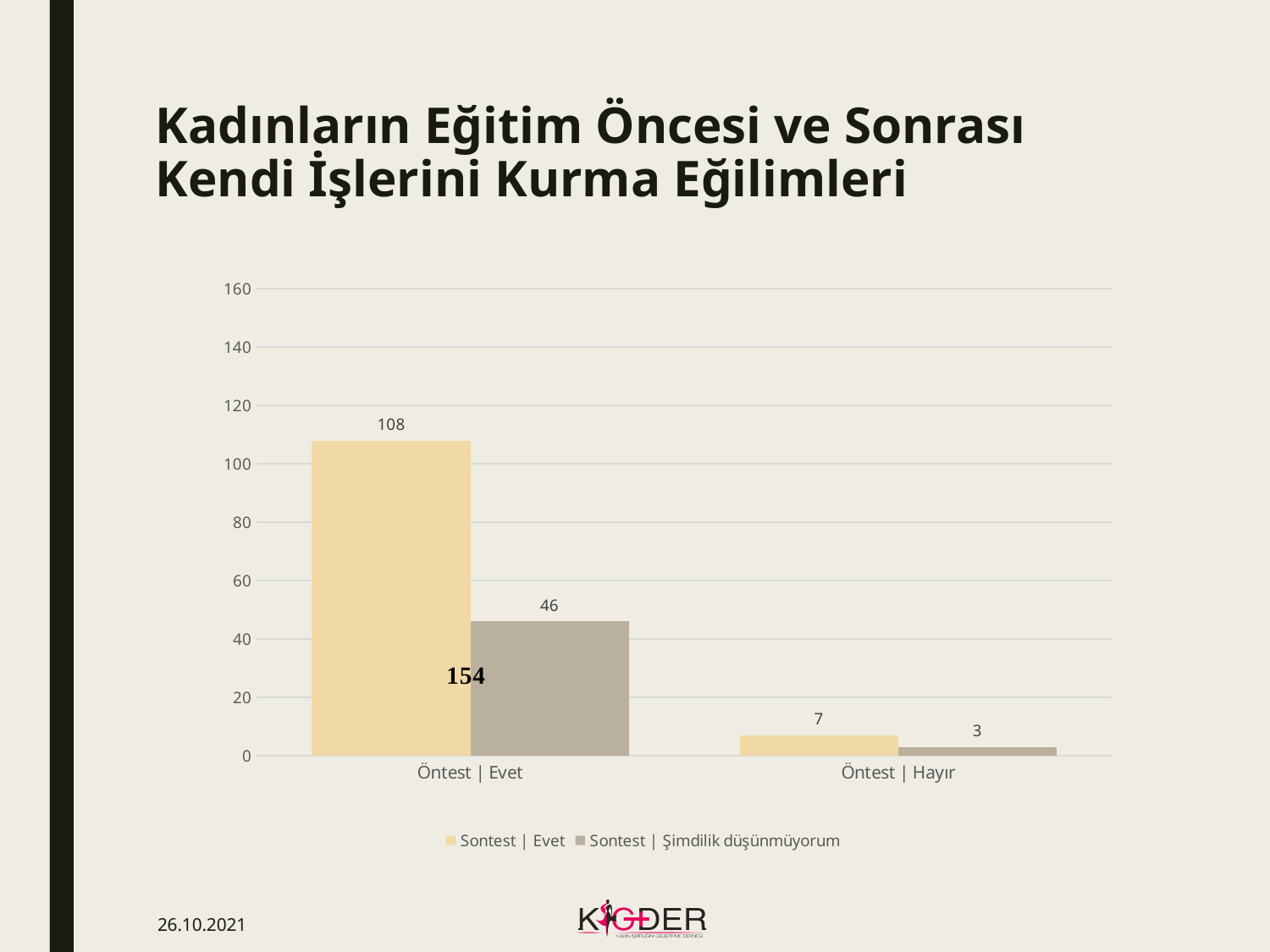
How many series does the chart legend list? 2 What is the value of the Sontest | Evet series for the Öntest | Hayır category? 7 For the Öntest | Hayır category, which series has the larger value: Sontest | Evet or Sontest | Şimdilik düşünmüyorum? Sontest | Evet How many categories are shown on the x axis of the chart? 2 What is the value of the Sontest | Şimdilik düşünmüyorum series for the Öntest | Hayır category? 3 What type of chart is shown on the slide? Bar chart What is the value of the Sontest | Evet series for the Öntest | Evet category? 108 Which bar has the lowest value in the chart? Sontest | Şimdilik düşünmüyorum for Öntest | Hayır Which bar has the highest value in the chart? Sontest | Evet for Öntest | Evet Is the Sontest | Evet value for Öntest | Evet greater or less than 100? greater What is the difference between the Sontest | Evet and Sontest | Şimdilik düşünmüyorum values for the Öntest | Evet category? 62 What is the value of the Sontest | Şimdilik düşünmüyorum series for the Öntest | Evet category? 46